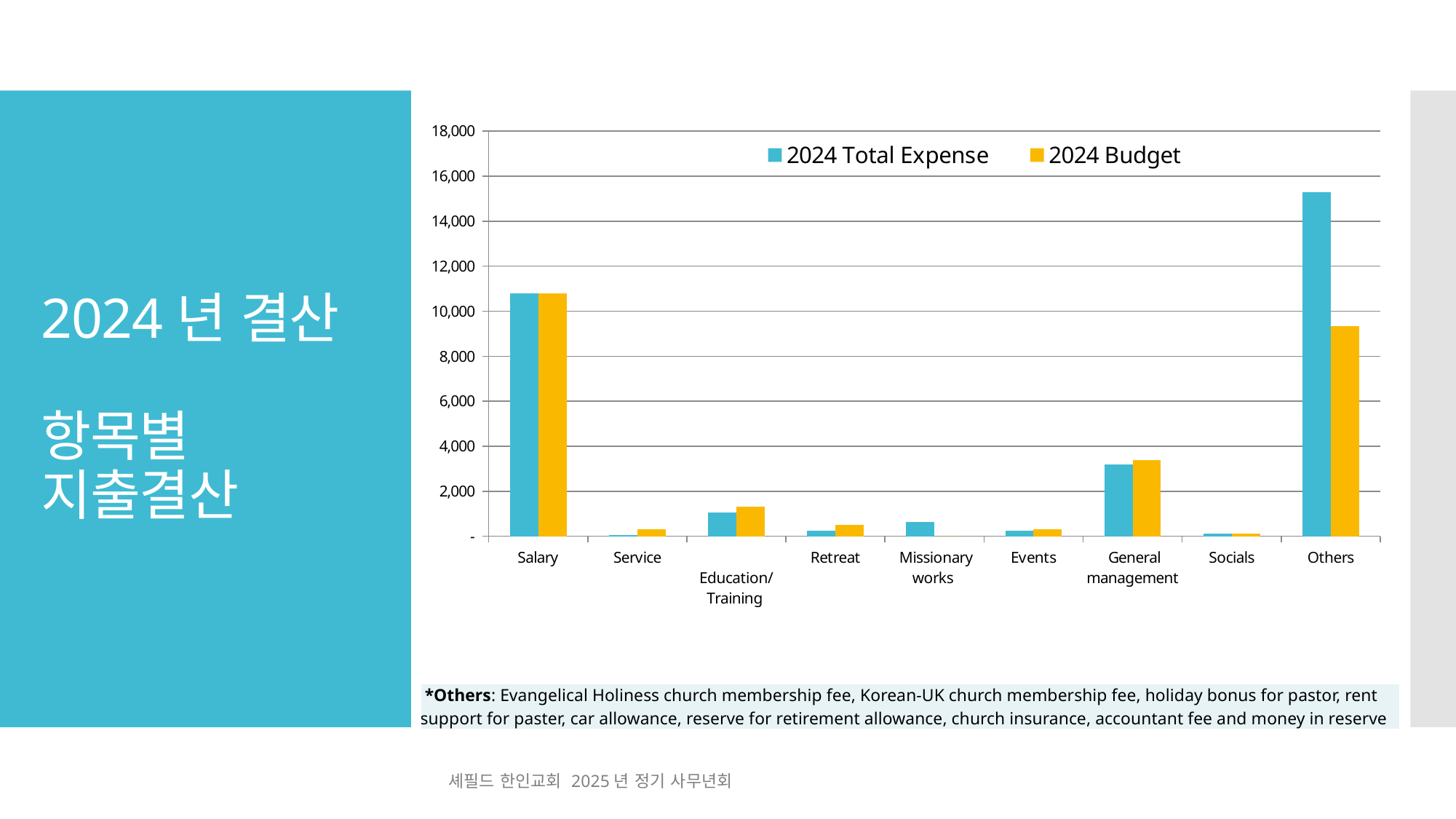
How many series does the legend list? 2 What kind of chart is shown on the slide? bar chart Which category has the highest 2024 Budget? Salary How many expense categories are shown on the x axis? 9 Which category has the highest 2024 Total Expense? Others Is the 2024 Budget for General management greater or less than 4,000? less Is the 2024 Total Expense for Salary greater or less than 10,000? greater Which colour represents the 2024 Budget series in the chart? yellow For General management, which is larger: the 2024 Total Expense or the 2024 Budget? 2024 Budget For Others, which is larger: the 2024 Total Expense or the 2024 Budget? 2024 Total Expense Is the 2024 Total Expense for Others greater or less than 14,000? greater